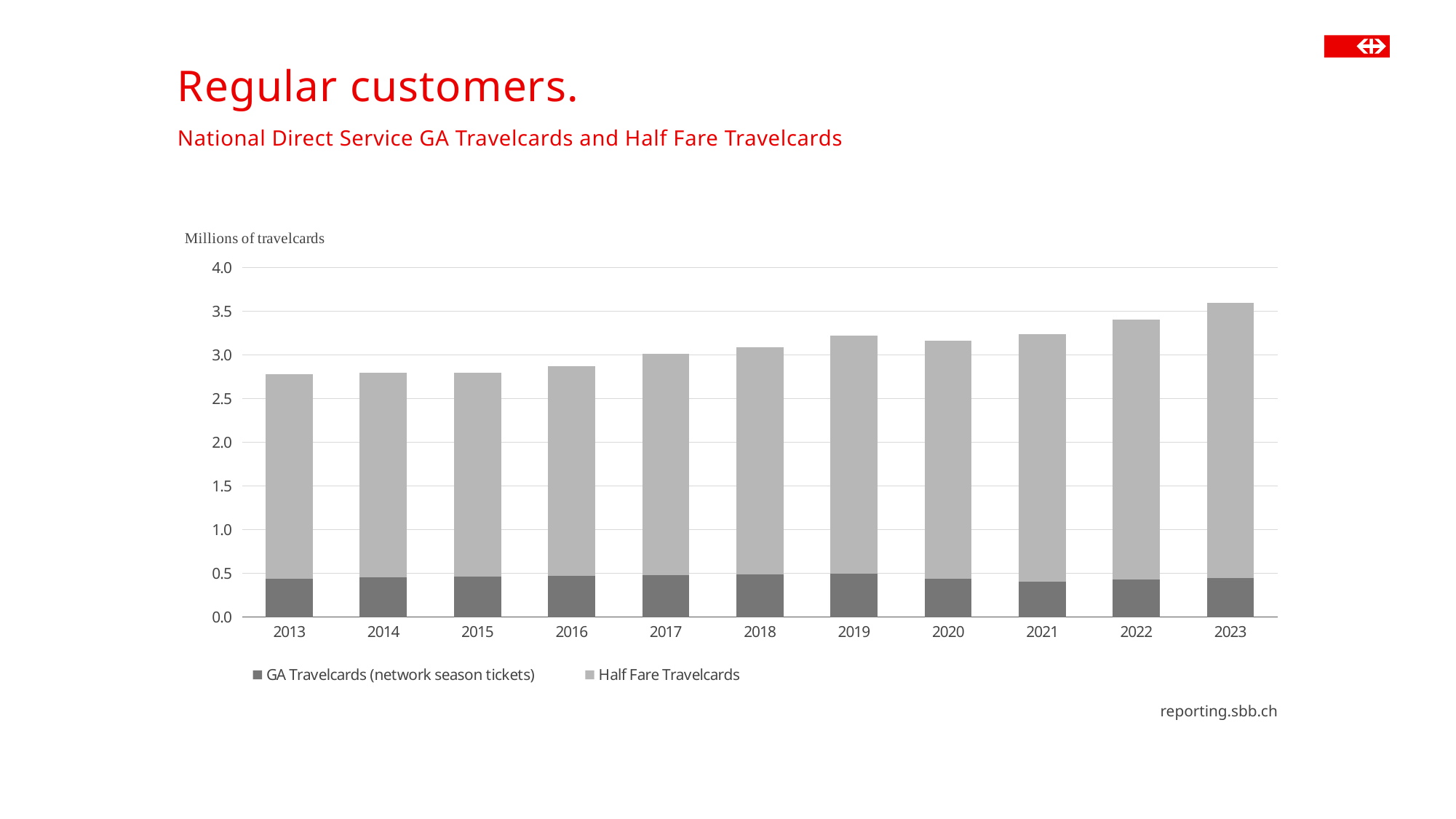
Is the total number of travelcards in 2013 greater or less than 3.0 million? less Which year has the highest total number of travelcards? 2023 What kind of chart is shown on the slide? Stacked bar chart How many series does the chart's legend list? 2 Which year has the larger total number of travelcards, 2013 or 2023? 2023 Which year has the larger total number of travelcards, 2018 or 2021? 2021 Does the total number of travelcards generally rise or fall from 2013 to 2023? rise How many years are shown on the x axis of the chart? 11 Is the total number of travelcards in 2023 greater or less than 3.5 million? greater Is the total number of travelcards in 2022 greater or less than 3.5 million? less What is the unit shown on the y axis of the chart? Millions of travelcards